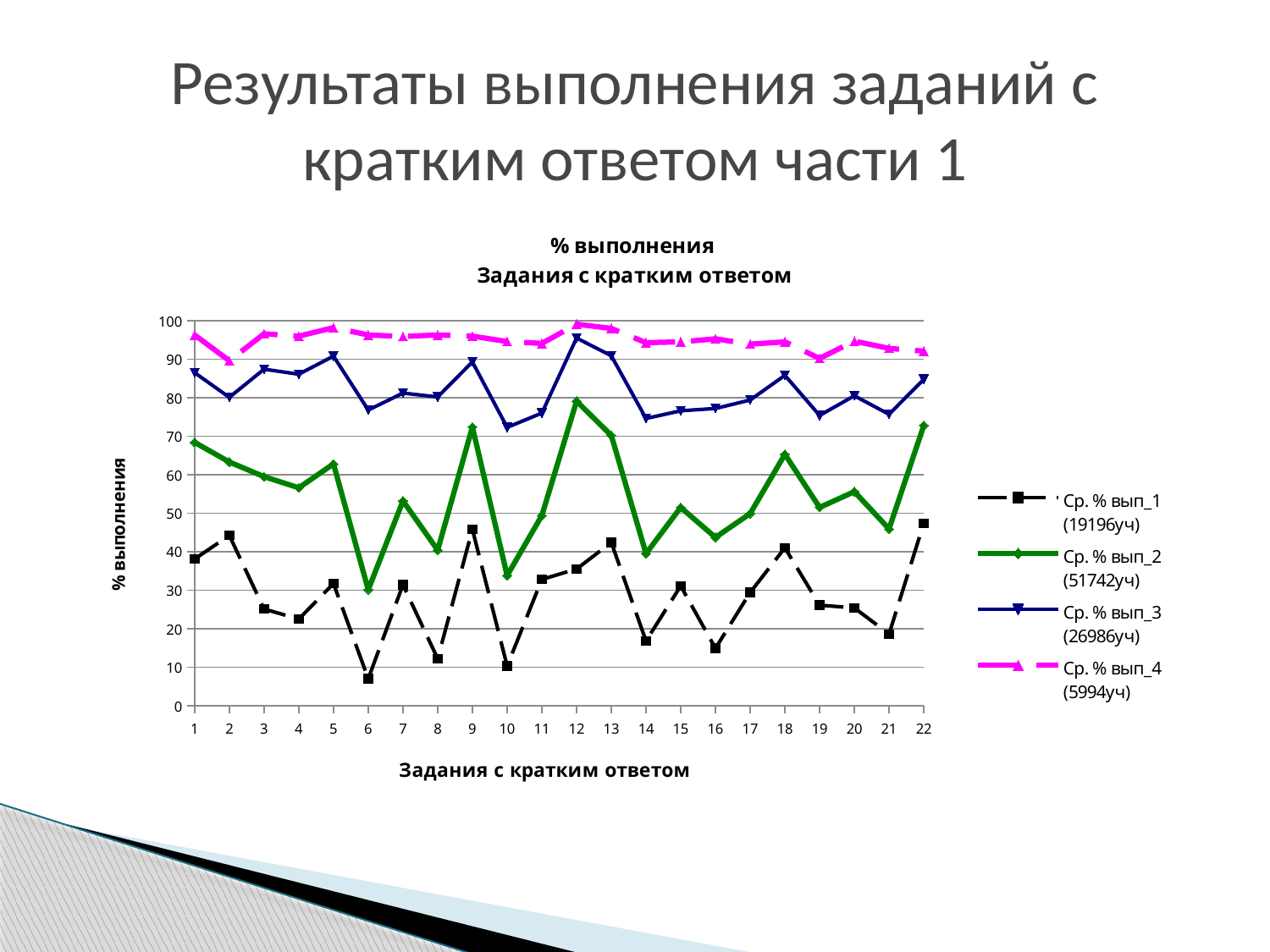
Is the value of Ср. % вып_2 (51742уч) for task 12 greater or less than 70? greater How many series does the legend list? 4 For Ср. % вып_1 (19196уч), is the value for task 2 or task 3 larger? task 2 For which task does Ср. % вып_2 (51742уч) reach its highest value? 12 What is the label of the y axis? % выполнения Is the value of Ср. % вып_4 (5994уч) for task 12 greater or less than 90? greater Which series has the highest values across all tasks? Ср. % вып_4 (5994уч) Is the value of Ср. % вып_1 (19196уч) for task 6 greater or less than 10? less How many tasks (categories) are plotted along the x axis? 22 What kind of chart is shown on the slide? line chart For which task does Ср. % вып_1 (19196уч) reach its lowest value? 6